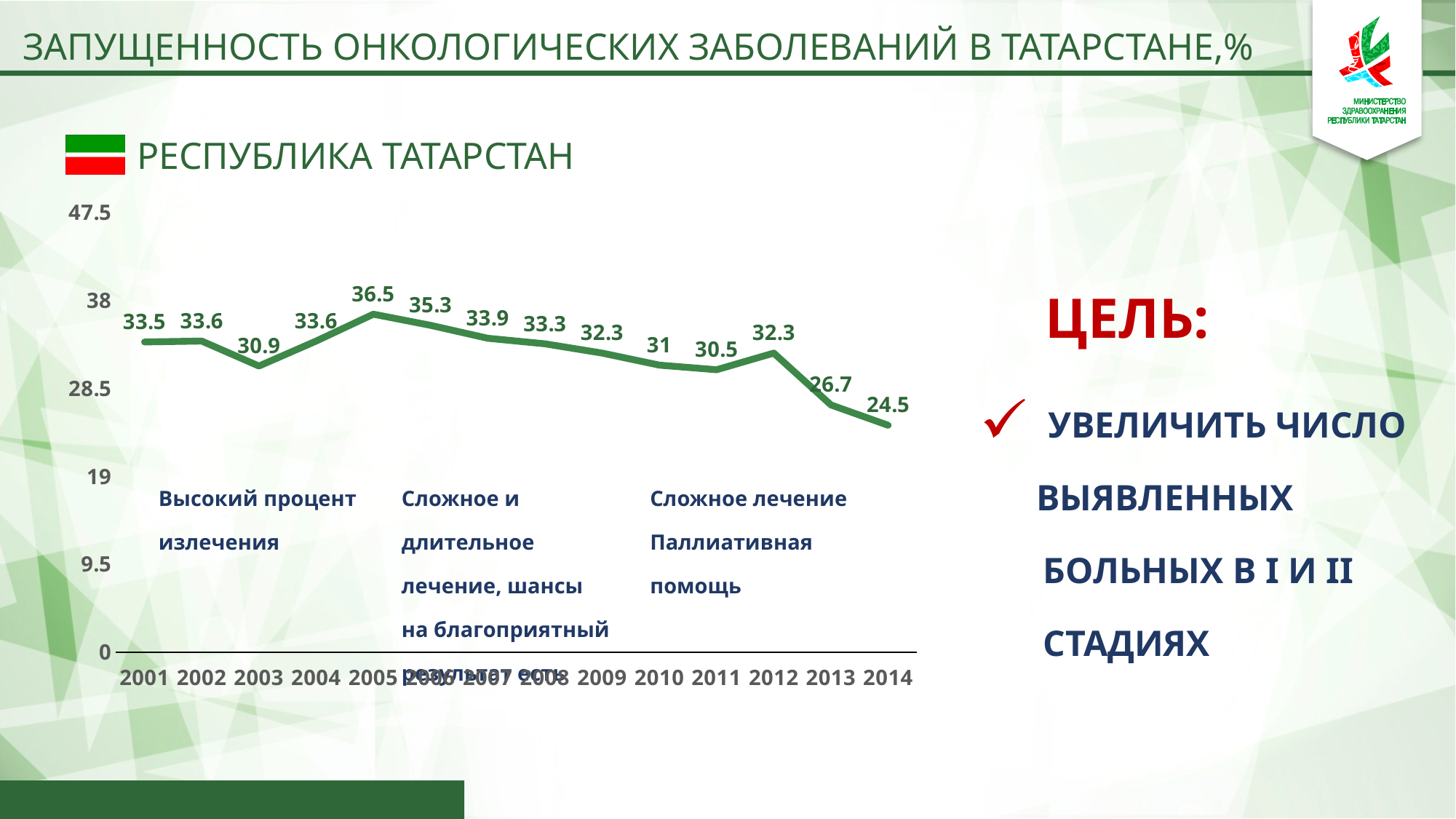
How many years are plotted on the x axis? 14 What is the difference between the values for 2005 and 2014? 12 Is the value for 2010 greater or less than 28.5? greater Does the value generally rise or fall from 2005 to 2014? fall Which is larger, the value for 2012 or the value for 2013? 2012 Which year has the highest value? 2005 What is the value for 2003? 30.9 What type of chart is shown on the slide? line chart What is the value for 2014? 24.5 Which year has the lowest value? 2014 What is the value for 2005? 36.5